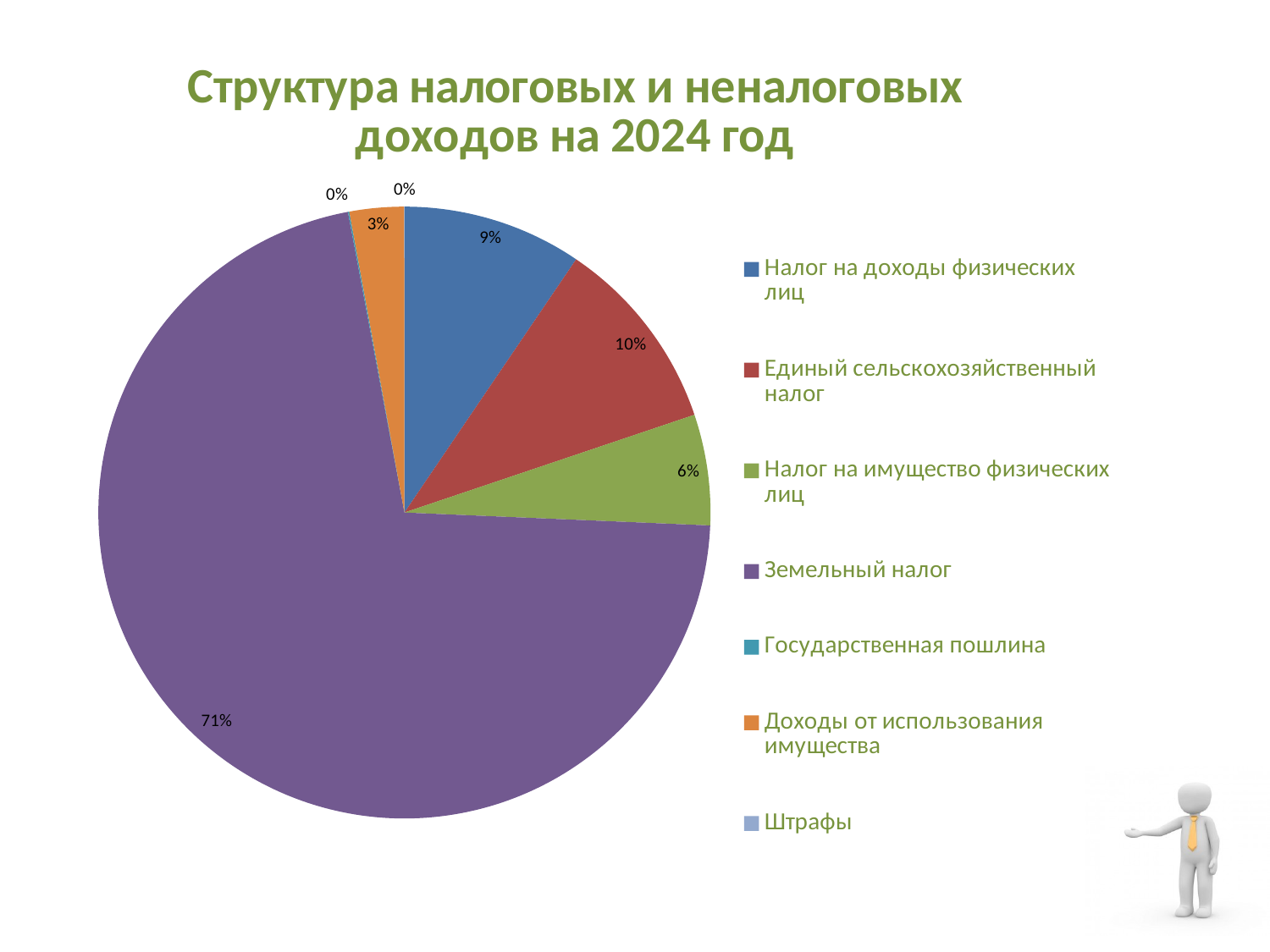
What kind of chart is shown on the slide? pie chart What is the title of the chart? Структура налоговых и неналоговых доходов на 2024 год What share of the pie does Земельный налог have? 71% What colour is the slice for Земельный налог? purple What is the value shown for Налог на доходы физических лиц? 9% Which is larger, the share of Налог на доходы физических лиц or the share of Доходы от использования имущества? Налог на доходы физических лиц What is the value shown for Доходы от использования имущества? 3% What is the value shown for Налог на имущество физических лиц? 6% How many categories does the legend list? 7 What is the value shown for Единый сельскохозяйственный налог? 10% What is the difference between the shares of Единый сельскохозяйственный налог and Налог на имущество физических лиц? 4% Which category has the largest slice of the pie? Земельный налог